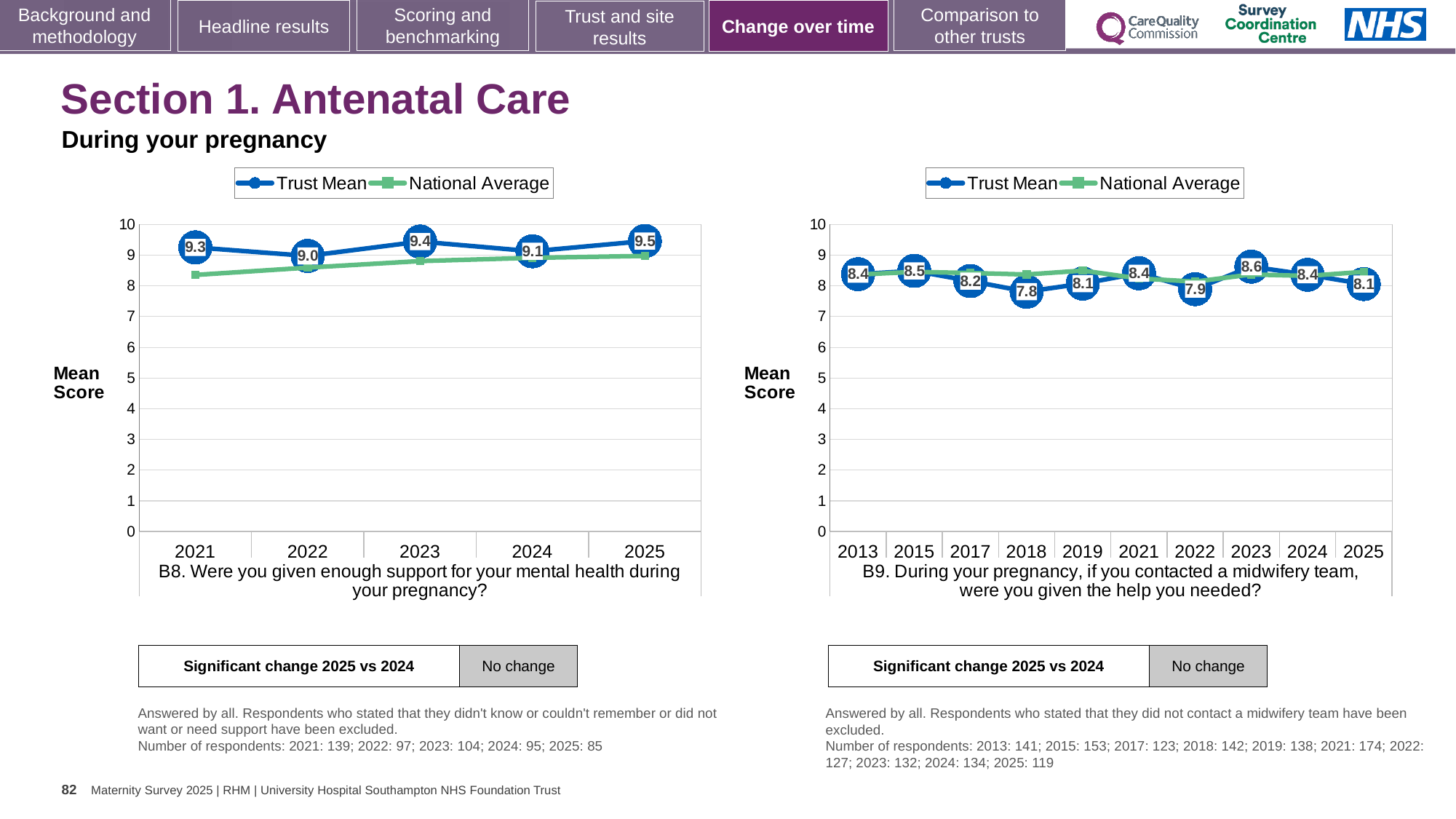
On the B8 chart (left), how many years are shown on the x axis? 5 On the B8 chart (left), which year has the lowest Trust Mean? 2022 On the B9 chart (right), what is the Trust Mean for 2018? 7.8 On the B8 chart (left), what is the Trust Mean for 2022? 9.0 On the B9 chart (right), how many years are shown on the x axis? 10 On the B9 chart (right), which year has the highest Trust Mean? 2023 On the B8 chart (left), what is the Trust Mean for 2025? 9.5 On the B8 chart (left), what is the difference between the Trust Mean for 2025 and 2024? 0.4 How many series does the legend of the B9 chart (right) list? 2 On the B9 chart (right), is the Trust Mean for 2023 larger or smaller than the Trust Mean for 2022? larger On the B9 chart (right), which year has the lowest Trust Mean? 2018 On the B8 chart (left), which year has the highest Trust Mean? 2025